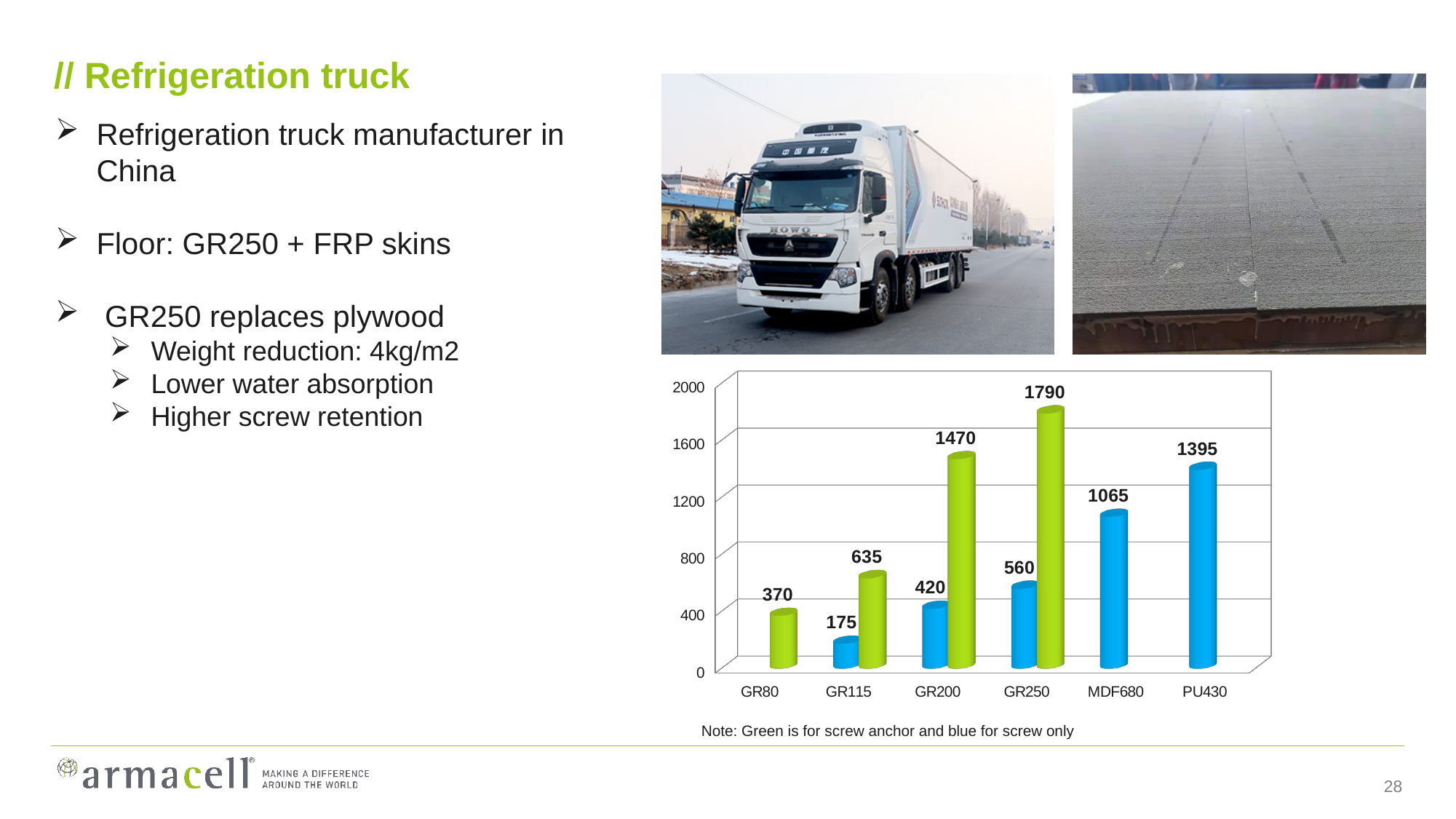
What is the green (screw anchor) value for GR250? 1790 What is the blue (screw only) value for PU430? 1395 What is the blue (screw only) value for GR115? 175 Which category has the lowest blue (screw only) bar? GR115 What kind of chart is shown on the slide? Bar chart How many categories are shown on the x axis of the chart? 6 What is the green (screw anchor) value for GR200? 1470 Do the green (screw anchor) values rise or fall from GR80 to GR250? Rise What is the difference between the green and blue values for GR250? 1230 Which category has the highest green (screw anchor) bar? GR250 According to the note under the chart, what do the blue bars represent? Screw only Which is larger: the blue value for MDF680 or the blue value for PU430? PU430